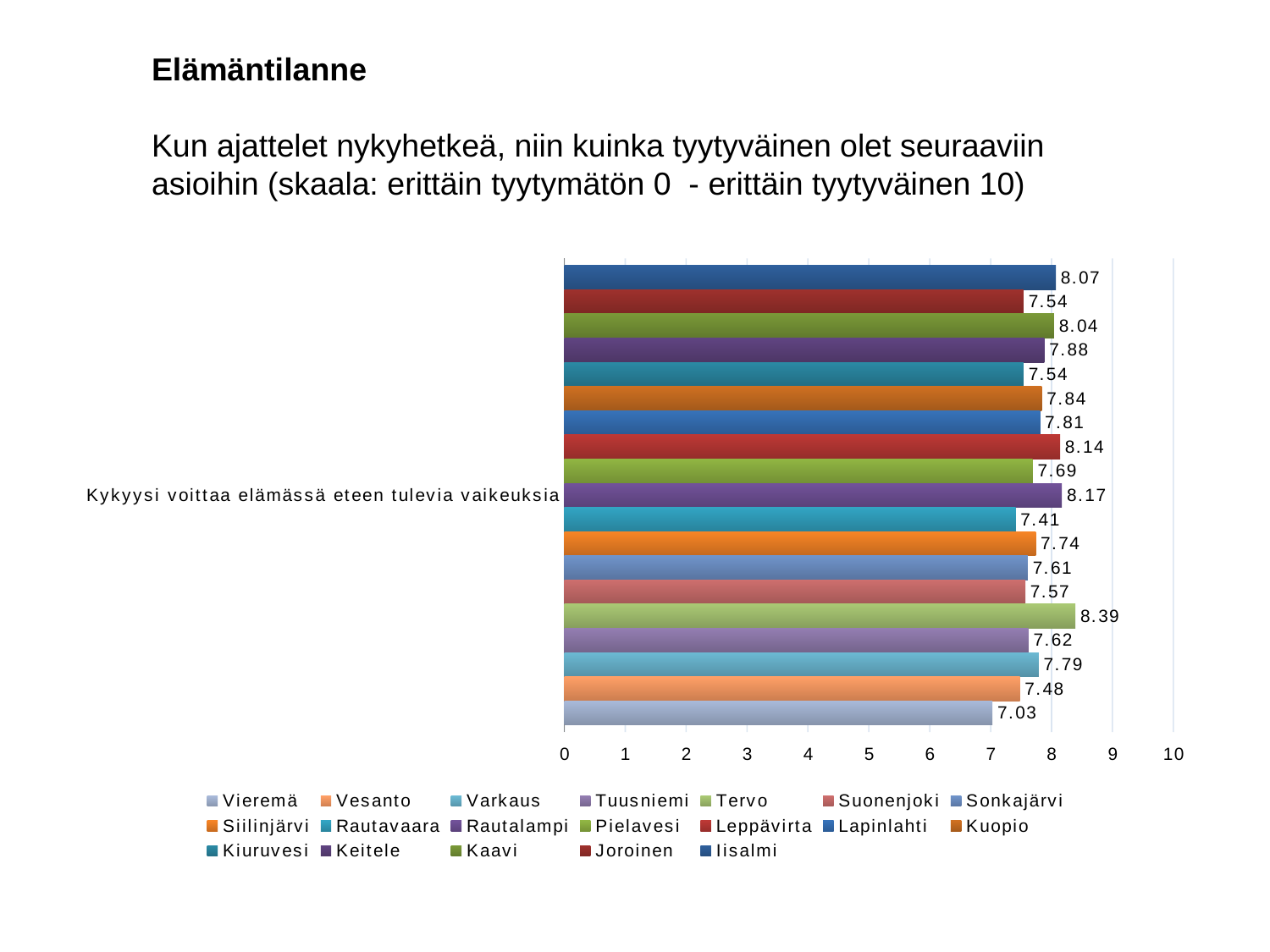
Which is larger, the value for Tervo or the value for Vesanto? Tervo How many series does the legend list? 19 What is the value for Tervo? 8.39 What is the value for Vieremä? 7.03 Which municipality has the highest value in the chart? Tervo What is the difference between the values for Tervo and Vieremä? 1.36 What kind of chart is shown on the slide? bar chart How many categories are shown on the vertical axis of the chart? 1 Which municipality has the lowest value in the chart? Vieremä What is the value for Vesanto? 7.48 What is the value for Iisalmi? 8.07 What is the category label shown on the vertical axis of the chart? Kykyysi voittaa elämässä eteen tulevia vaikeuksia